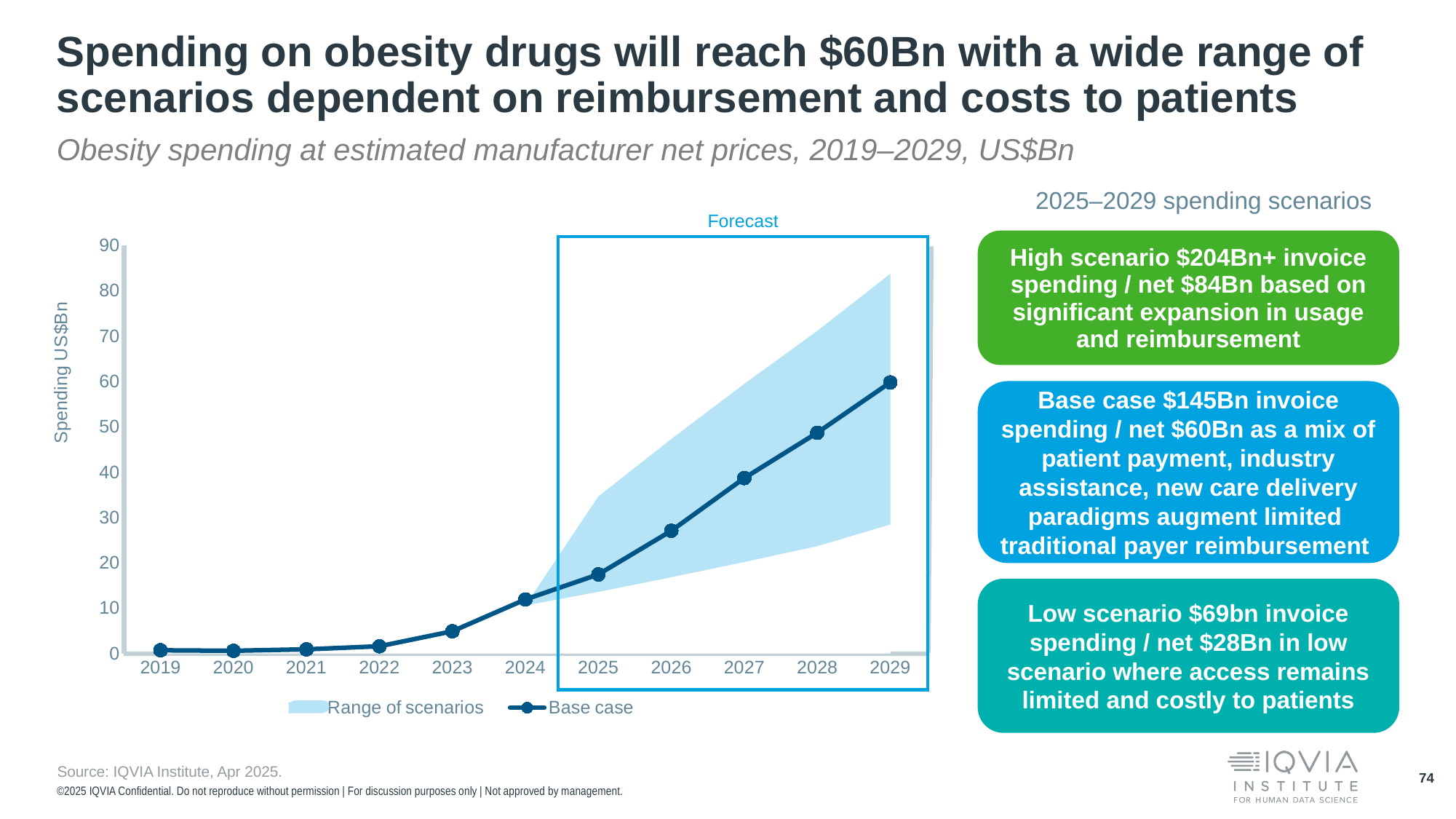
In which year is the base case spending highest? 2029 What kind of chart is shown on the slide? combination area and line chart In which year does the Forecast box on the chart begin? 2025 Is the base case value for 2025 greater or less than 20? less What is the label on the y axis of the chart? Spending US$Bn Is the base case value for 2024 greater or less than 10? greater Which year has the larger base case value, 2025 or 2027? 2027 Is the base case value for 2026 greater or less than 30? less Does the base case line rise or fall from 2019 to 2029? rise How many years are plotted along the x axis of the chart? 11 How many series does the chart legend list? 2